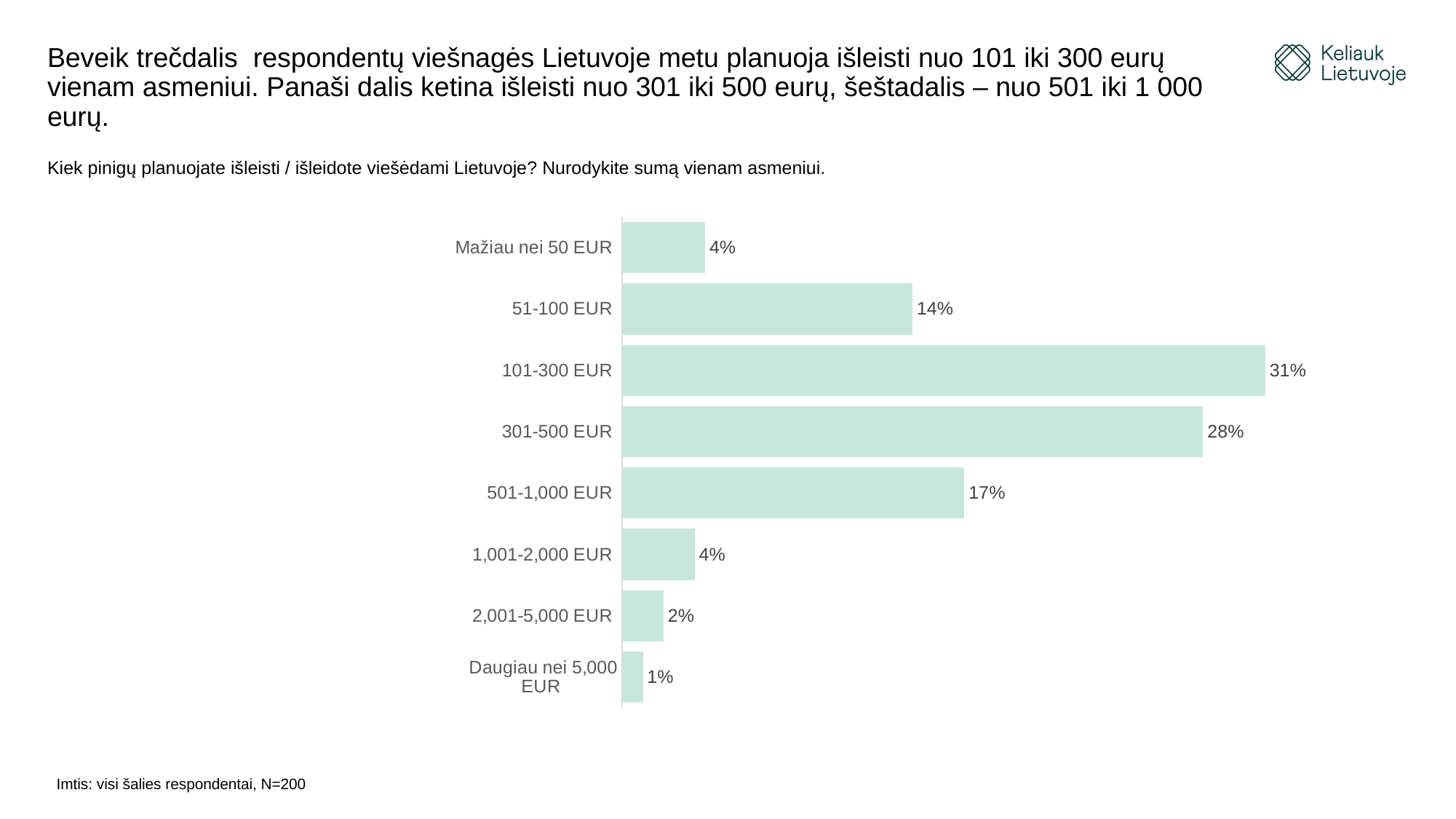
Which spending category has the highest share of respondents? 101-300 EUR What is the sample size stated at the bottom of the slide? N=200 Which spending category has the lowest share of respondents? Daugiau nei 5,000 EUR What type of chart is shown on the slide? Bar chart What percentage is shown for 501-1,000 EUR? 17% How many spending categories are shown in the chart? 8 What is the difference in percentage points between the 501-1,000 EUR and 51-100 EUR categories? 3 What is the value shown for the 51-100 EUR category? 14% What is the difference in percentage points between the 101-300 EUR and 301-500 EUR categories? 3 What percentage of respondents plan to spend 101-300 EUR per person? 31% What is the value for the 2,001-5,000 EUR category? 2% Which is larger, the value for 301-500 EUR or the value for 501-1,000 EUR? 301-500 EUR